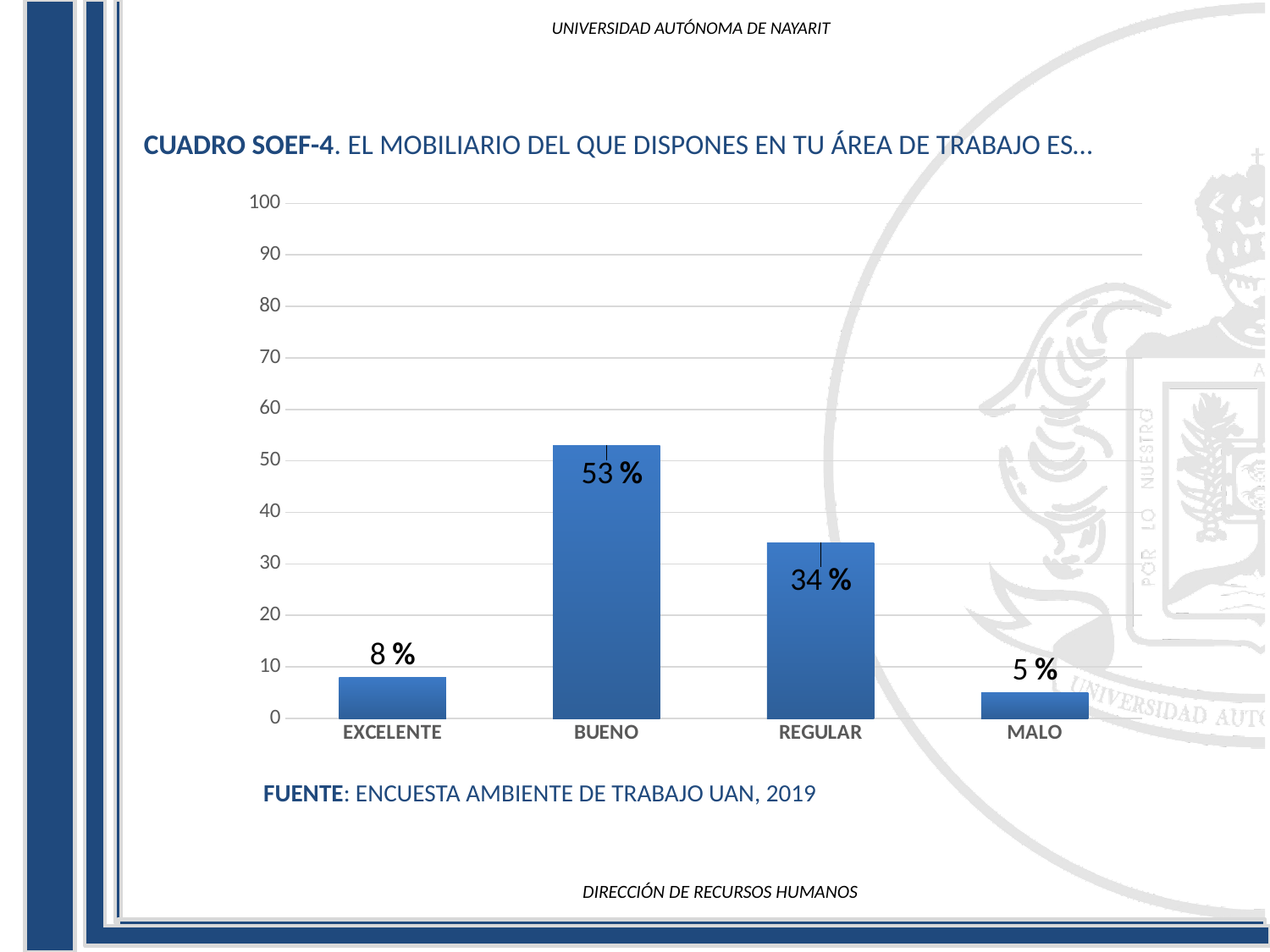
Which category has the lowest value? MALO Which is larger, the value for EXCELENTE or the value for MALO? EXCELENTE What is the value for EXCELENTE? 8 % What is the value for REGULAR? 34 % How many categories are shown on the x axis? 4 What is the source cited below the chart? ENCUESTA AMBIENTE DE TRABAJO UAN, 2019 What is the value for BUENO? 53 % What kind of chart is shown on the slide? bar chart Which category has the highest value? BUENO What is the difference between the values for BUENO and REGULAR? 19 % What is the value for MALO? 5 % Is the value for REGULAR greater or less than 40? less